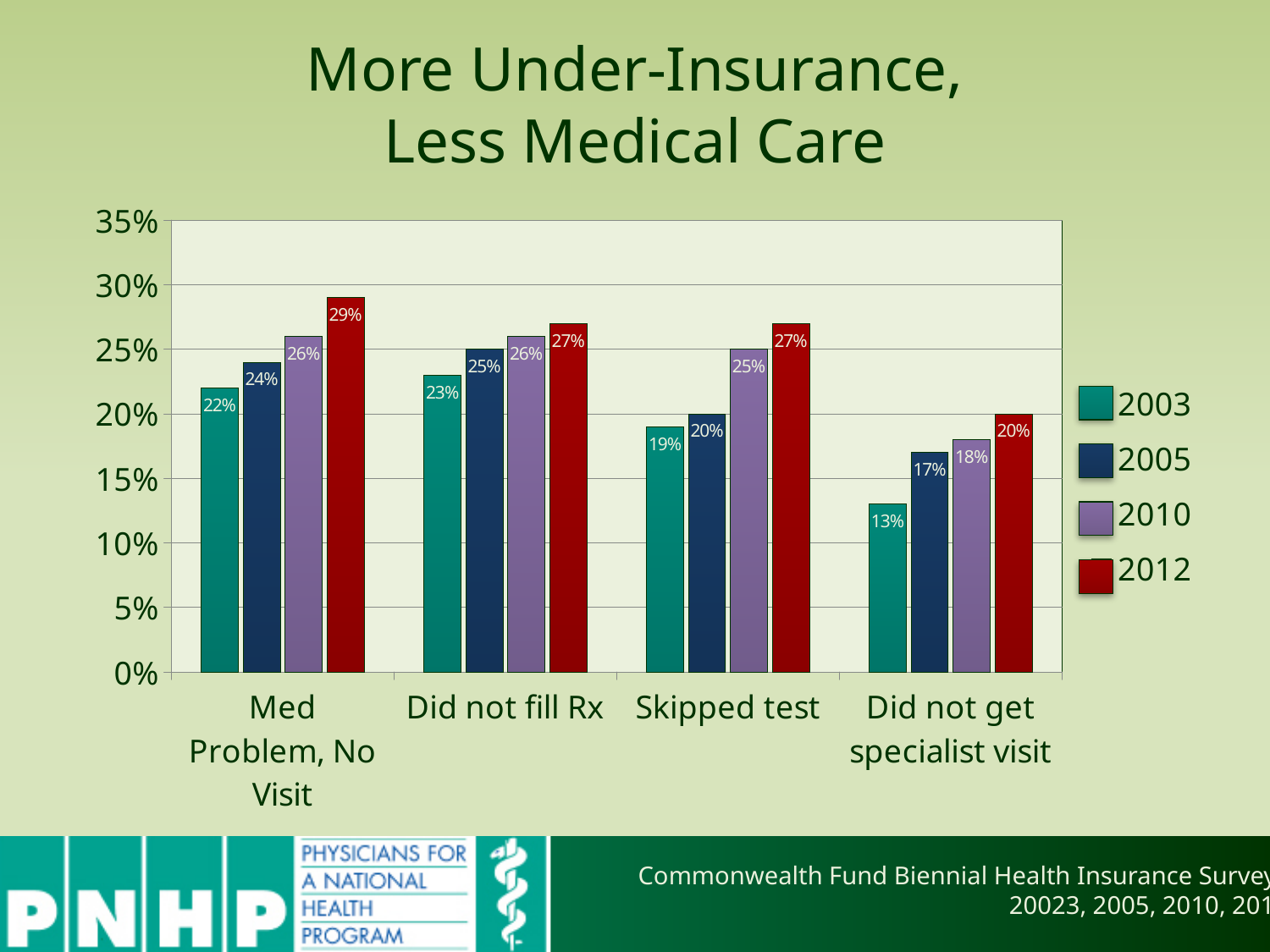
What is the difference between the 2012 and 2003 values for Did not get specialist visit? 7% Do the values for Did not fill Rx rise or fall from 2003 to 2012? rise Which category has the highest 2012 value? Med Problem, No Visit What kind of chart is shown on the slide? bar chart How many series does the legend list? 4 How many categories are shown on the x axis? 4 What is the 2010 value for Skipped test? 25% What is the 2003 value for Did not get specialist visit? 13% What is the 2005 value for Did not fill Rx? 25% Which is larger for Skipped test: the 2003 value or the 2012 value? 2012 What is the 2012 value for Med Problem, No Visit? 29% Which category has the lowest 2003 value? Did not get specialist visit